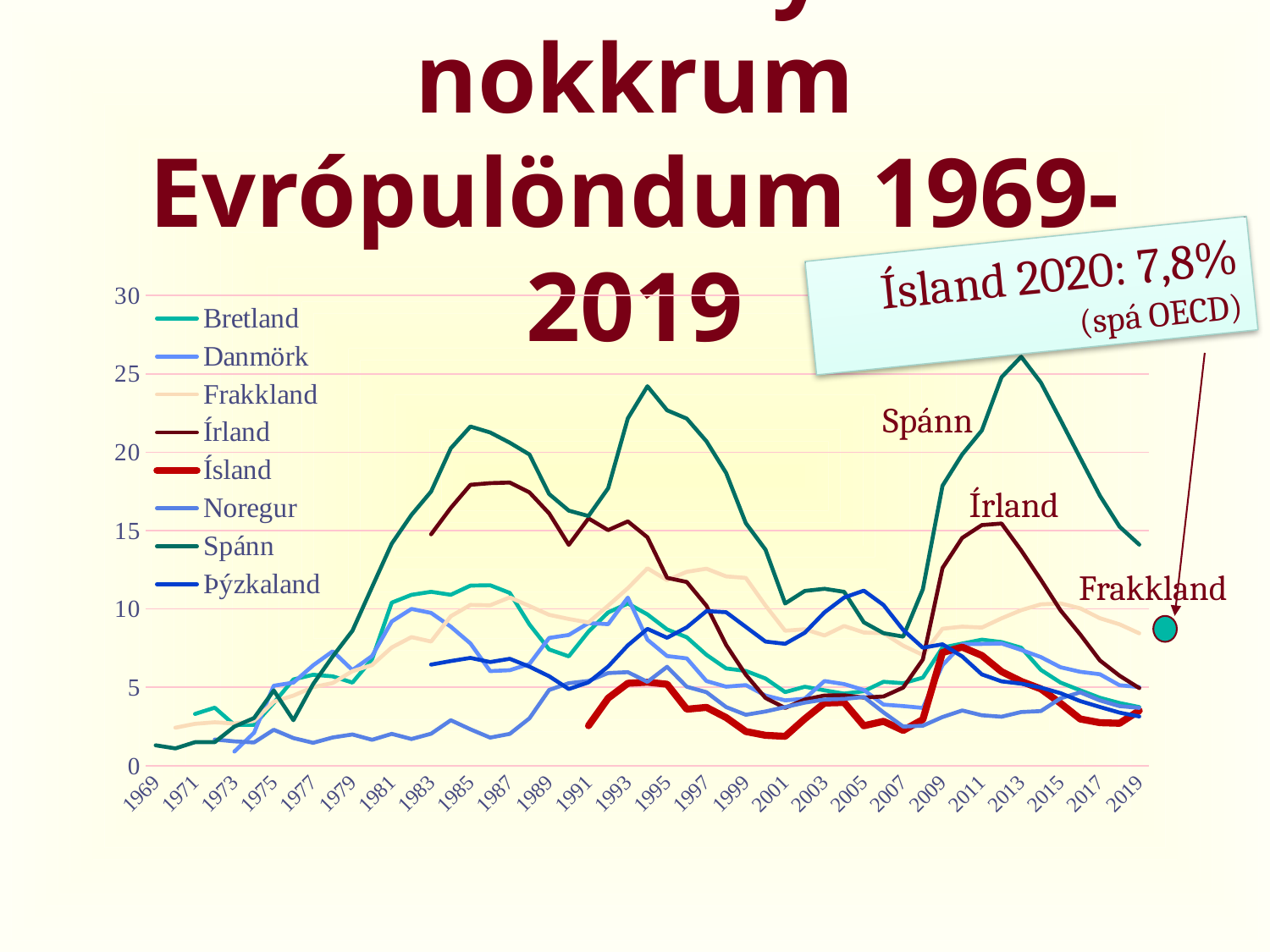
Is the value for Frakkland in 2019 greater or less than 10? less Is the value for Spánn in 1985 greater or less than 20? greater Is the value for Ísland in 2001 greater or less than 5? less Which series is drawn with the thick red line? Ísland What value does the annotation box give for Ísland in 2020? 7,8% What kind of chart is shown on the slide? line chart Which is larger in 2013, the value for Spánn or the value for Ísland? Spánn Does the Spánn line rise or fall from 2013 to 2019? fall Which series reaches the highest value anywhere on the chart? Spánn How many series does the legend list? 8